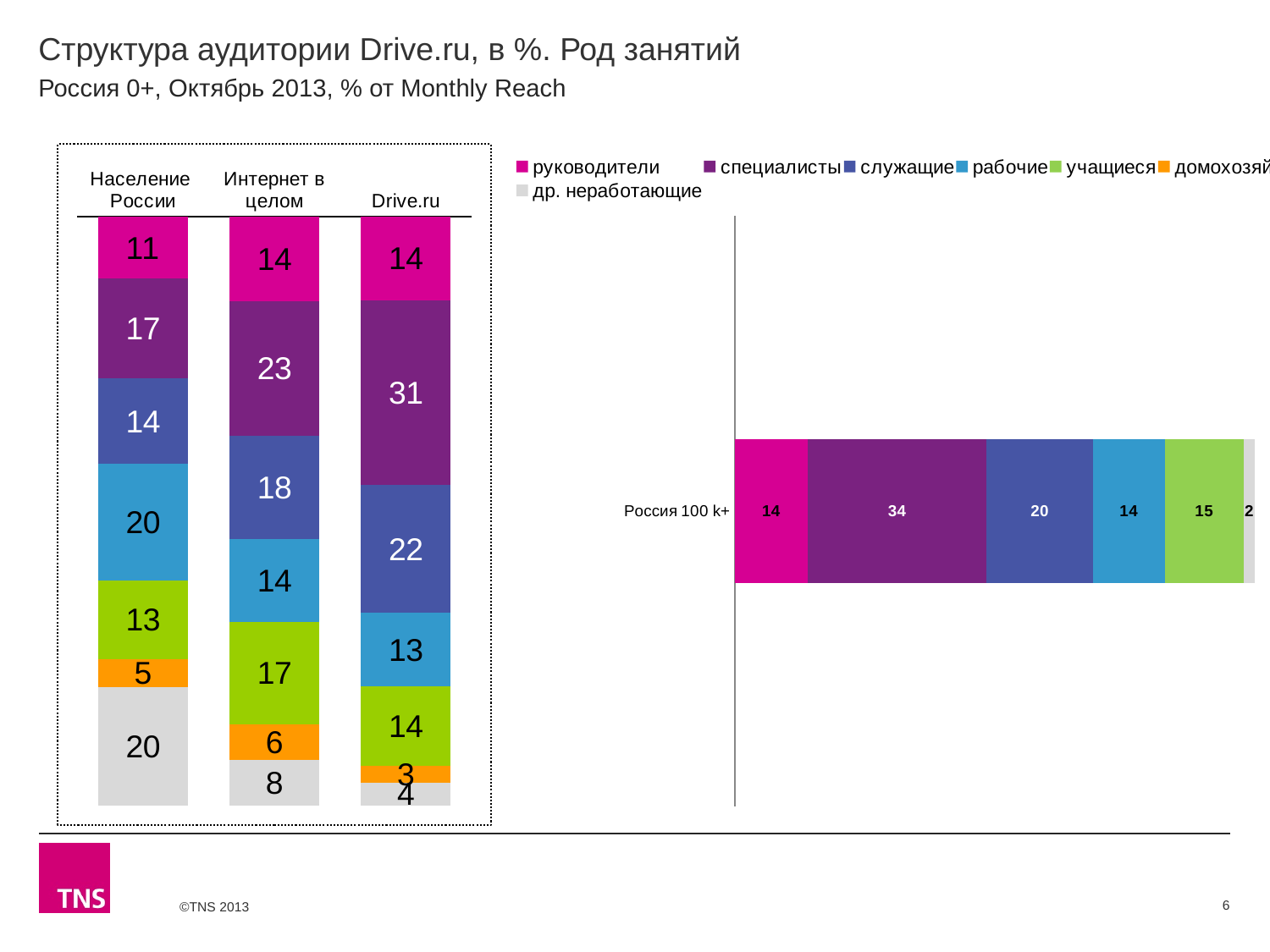
In the right chart (Россия 100 k+), which occupation group has the smallest labelled value? домохозяйки In the left chart, what is the value for учащиеся in the Интернет в целом column? 17 In the left chart, what is the value for специалисты in the Drive.ru column? 31 How many series does the legend list? 7 In the left chart, what is the value for др. неработающие in the Население России column? 20 In the left chart, what is the difference between the специалисты value for Drive.ru and for Население России? 14 In the right chart (Россия 100 k+), what is the value for специалисты? 34 What kind of chart is the right chart (Россия 100 k+)? stacked bar chart In the left chart, which occupation group has the largest share in the Drive.ru column? специалисты In the left chart, which is larger: the рабочие value for Население России or for Drive.ru? Население России How many columns (audience groups) are shown in the left chart? 3 In the left chart, what is the total of the Интернет в целом column? 100